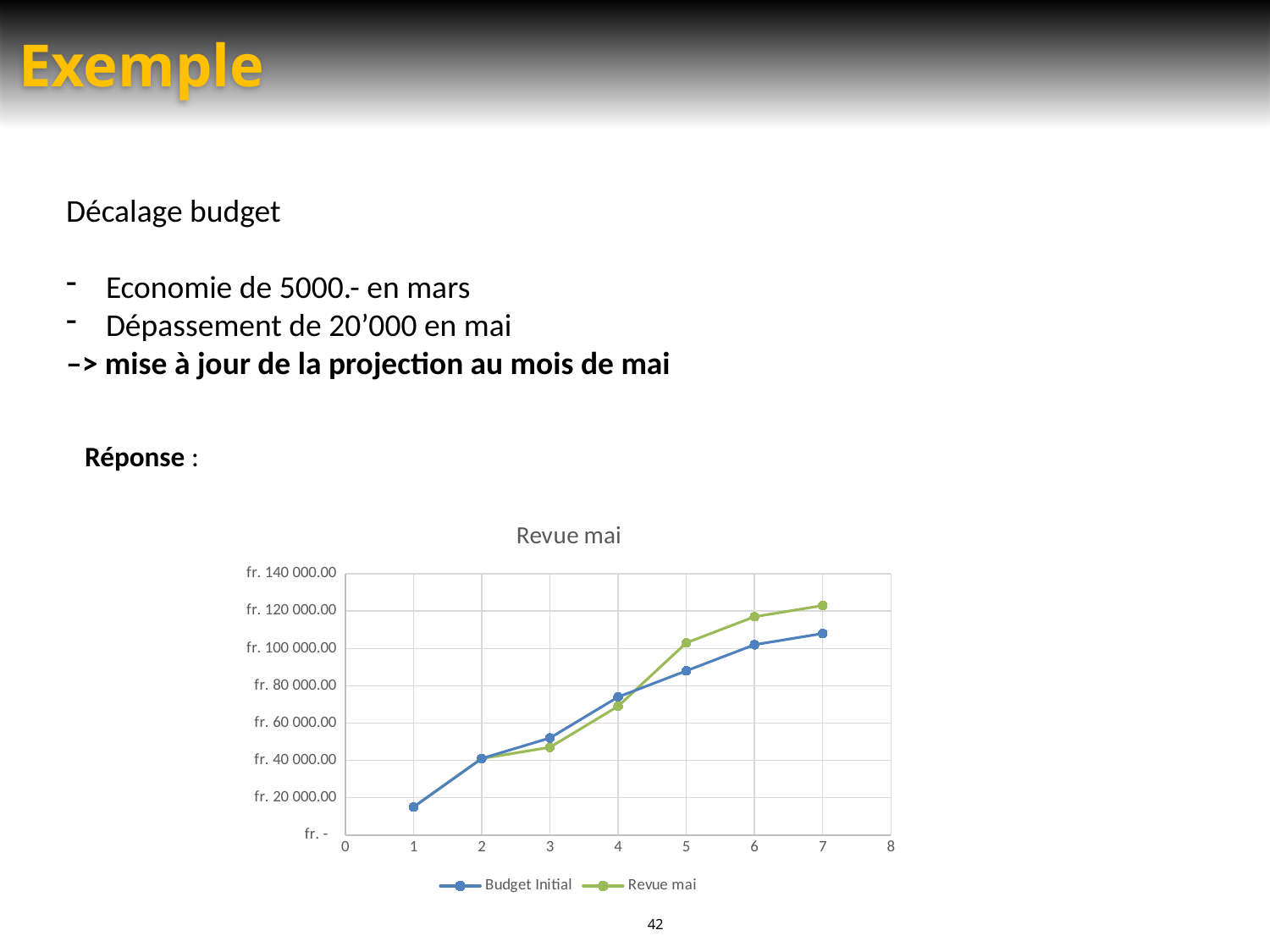
At x = 5, which series has the higher value, Budget Initial or Revue mai? Revue mai What kind of chart is shown on the slide? line chart What is the title of the chart? Revue mai Is the value of Budget Initial at x = 7 greater or less than fr. 100 000.00? greater At x = 3, which series has the higher value, Budget Initial or Revue mai? Budget Initial Is the value of Revue mai at x = 4 greater or less than fr. 80 000.00? less At x = 7, which series has the higher value, Budget Initial or Revue mai? Revue mai Which colour is used for the Budget Initial series? blue Is the value of Budget Initial at x = 1 greater or less than fr. 20 000.00? less Do the values of the Budget Initial series rise or fall from x = 1 to x = 7? rise How many series does the chart legend list? 2 How many data points are plotted for the Revue mai series? 7